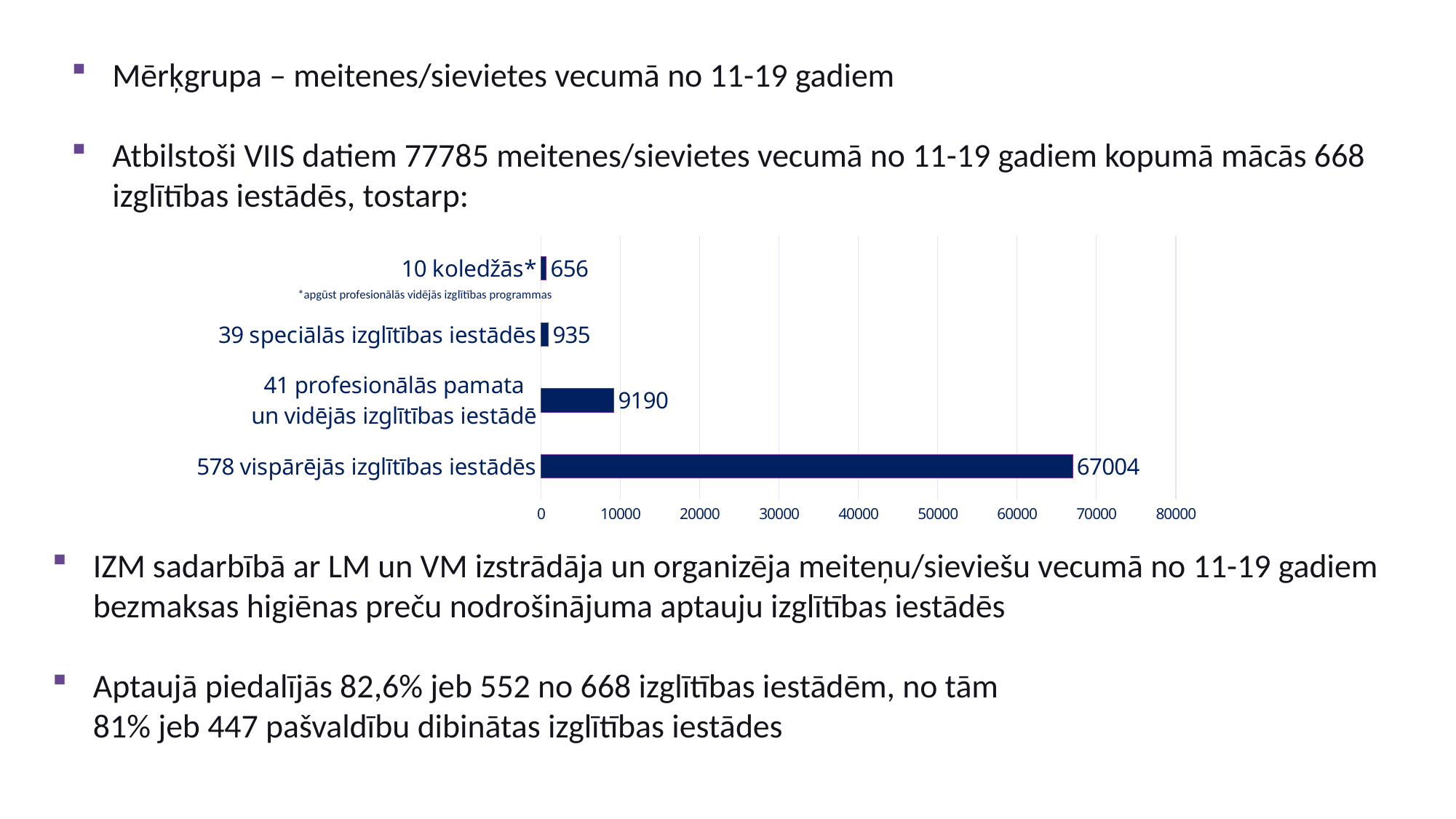
Which category has the highest value? 578 vispārējās izglītības iestādēs Is the value for "578 vispārējās izglītības iestādēs" greater or less than 60000? greater What is the value for "578 vispārējās izglītības iestādēs"? 67004 What is the difference between the values for "39 speciālās izglītības iestādēs" and "10 koledžās*"? 279 Which is larger: the value for "41 profesionālās pamata un vidējās izglītības iestādē" or for "39 speciālās izglītības iestādēs"? 41 profesionālās pamata un vidējās izglītības iestādē How many categories are shown in the chart? 4 What is the value for "41 profesionālās pamata un vidējās izglītības iestādē"? 9190 What kind of chart is shown on the slide? bar chart What is the difference between the values for "578 vispārējās izglītības iestādēs" and "41 profesionālās pamata un vidējās izglītības iestādē"? 57814 What is the value for "10 koledžās*"? 656 Which category has the lowest value? 10 koledžās* What is the value for "39 speciālās izglītības iestādēs"? 935